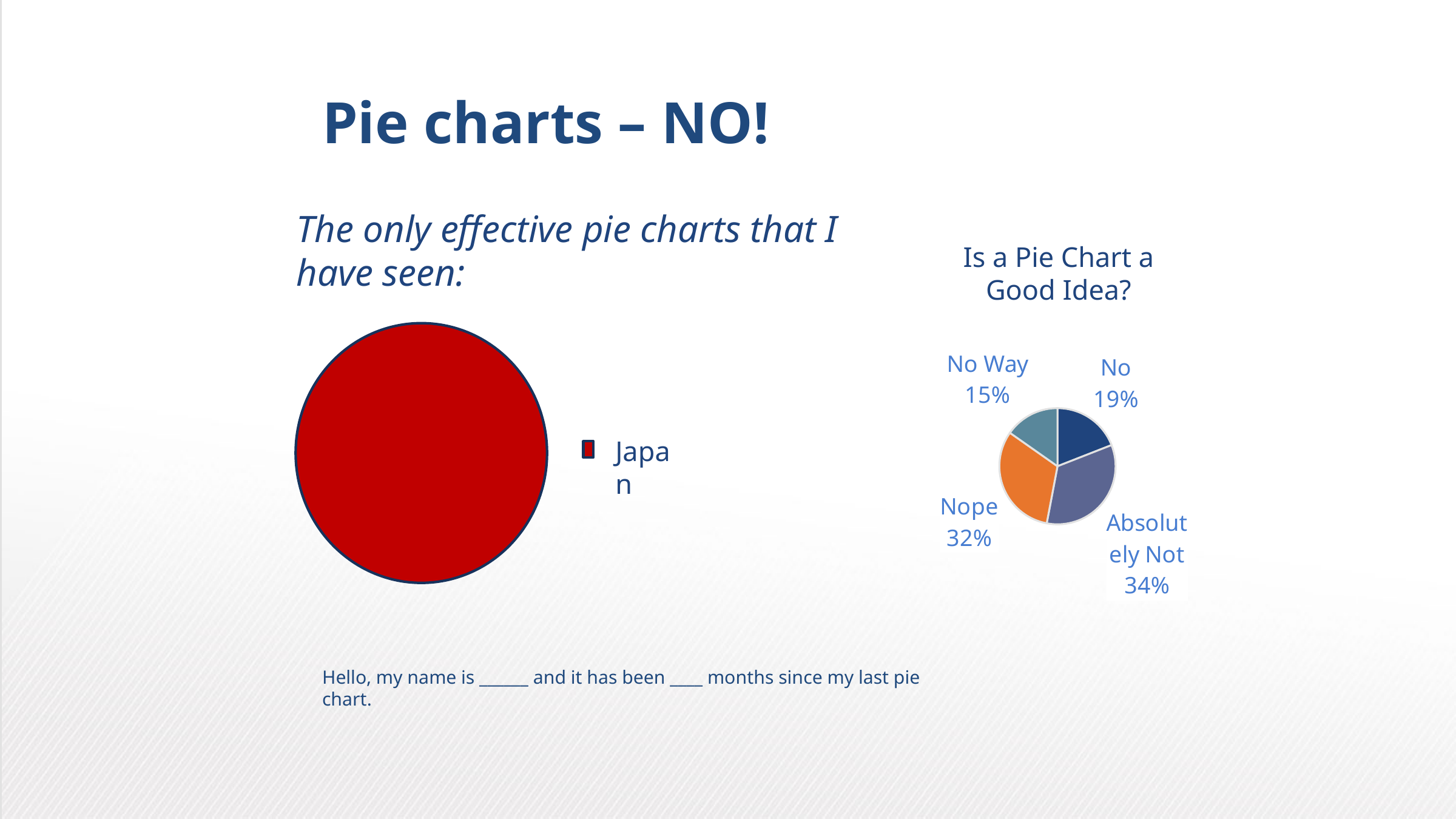
In the chart titled "Is a Pie Chart a Good Idea?", which slice is the largest? Absolutely Not How many slices does the chart titled "Is a Pie Chart a Good Idea?" have? 4 In the chart titled "Is a Pie Chart a Good Idea?", what share does the "Nope" slice have? 32% In the chart titled "Is a Pie Chart a Good Idea?", which is larger, "No" or "No Way"? No In the chart titled "Is a Pie Chart a Good Idea?", what share does the "No Way" slice have? 15% What is the only legend entry for the chart on the left of the slide? Japan In the chart titled "Is a Pie Chart a Good Idea?", what share does the "Absolutely Not" slice have? 34% What is the title of the chart on the right of the slide? Is a Pie Chart a Good Idea? What kind of chart is the chart on the left of the slide? Pie chart In the chart titled "Is a Pie Chart a Good Idea?", which slice is the smallest? No Way In the chart titled "Is a Pie Chart a Good Idea?", what is the difference in percentage points between "Nope" and "No"? 13 In the chart titled "Is a Pie Chart a Good Idea?", what share does the "No" slice have? 19%